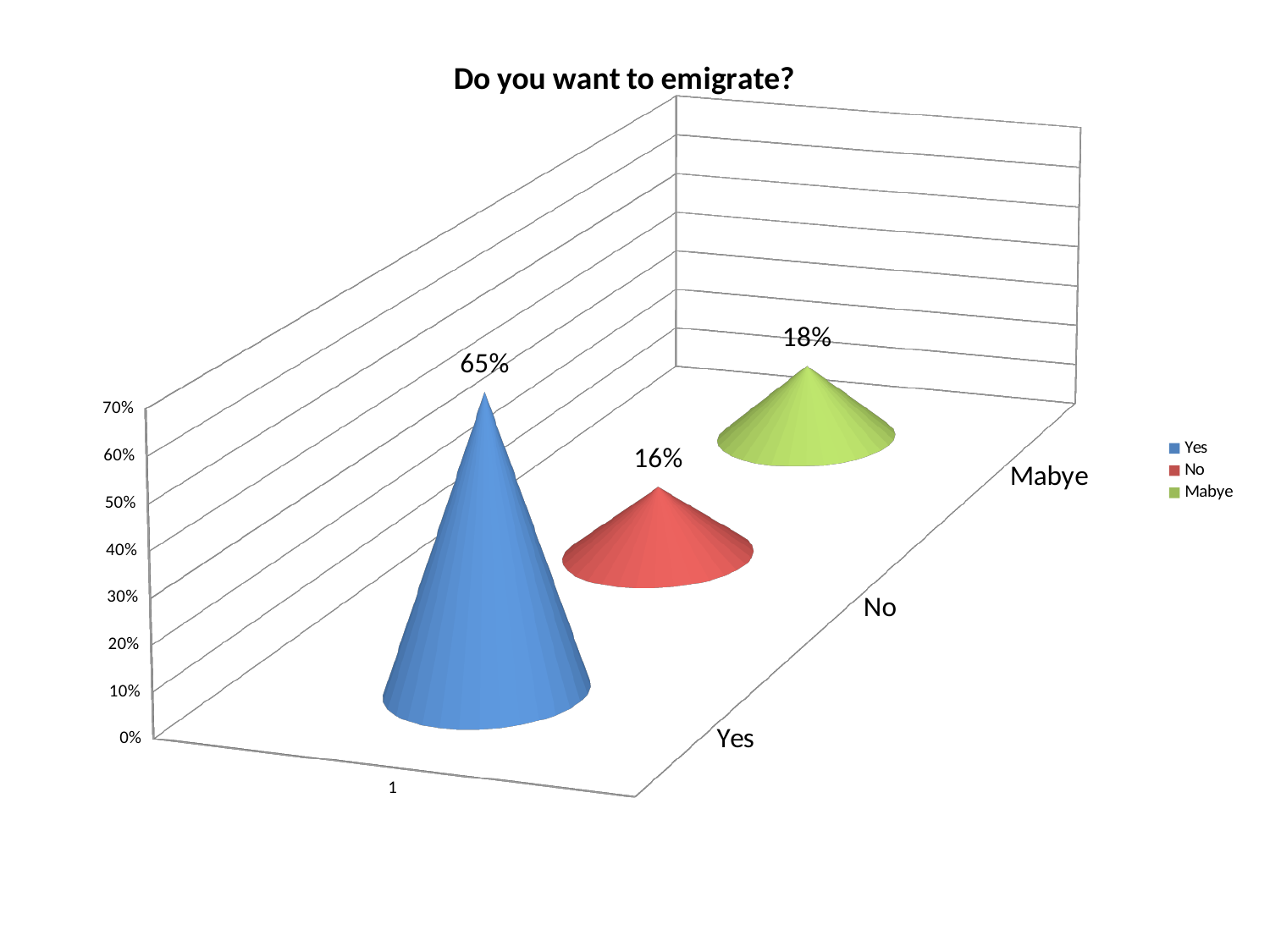
Which response has the lowest value? No Which is larger, the value for Yes or the value for Mabye? Yes What is the difference between the values for Mabye and No? 2% How many series does the legend list? 3 What is the difference between the values for Yes and No? 49% What is the value for No? 16% What is the value for Yes? 65% What colour represents the No series? Red Is the value for Yes greater or less than 60%? greater Which response has the highest value? Yes What is the value for Mabye? 18% What is the title of the chart? Do you want to emigrate?